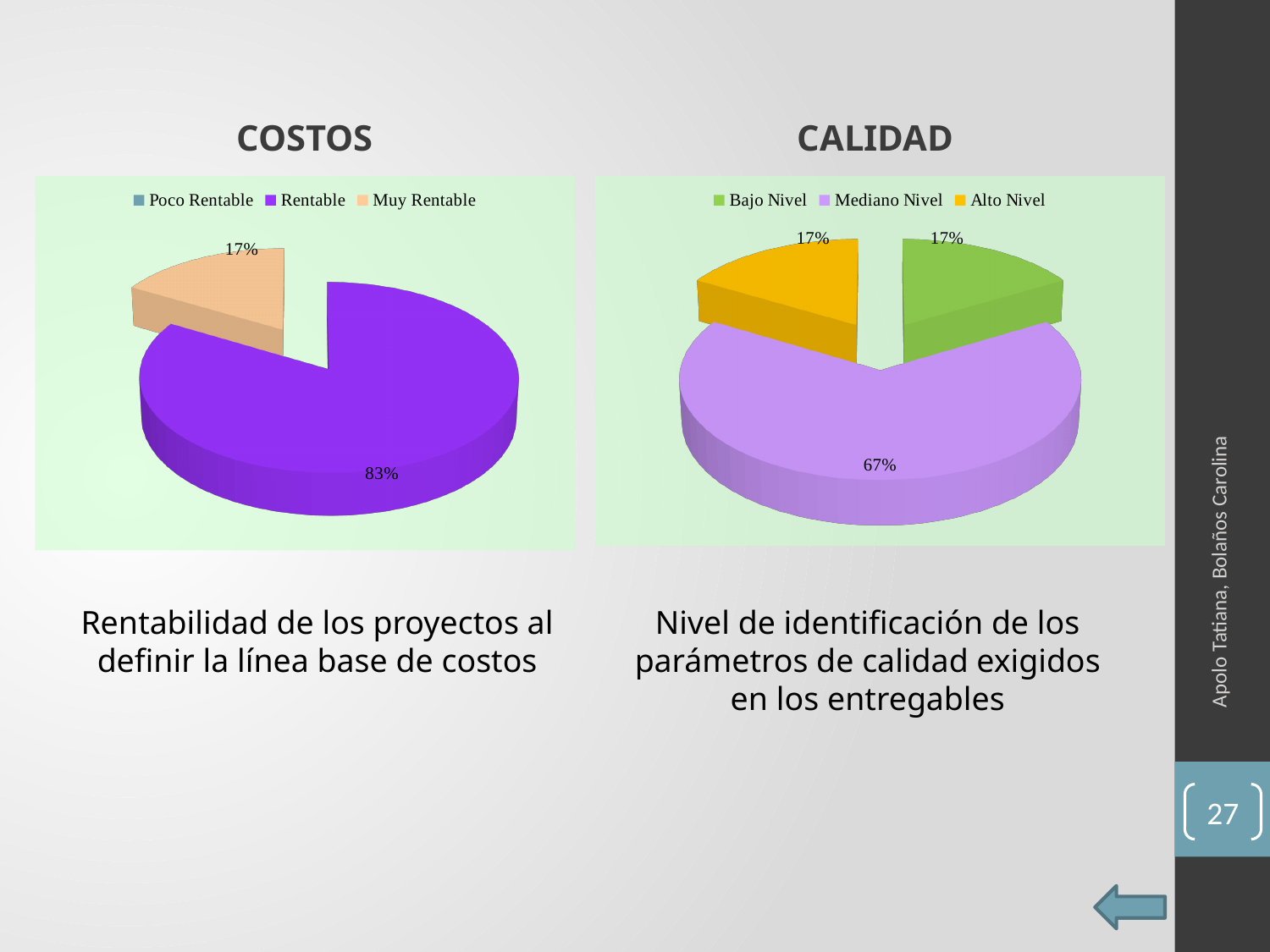
In the COSTOS chart, how many entries does the legend list? 3 In the CALIDAD chart, which category has the largest slice? Mediano Nivel In the COSTOS chart, which category has the largest slice? Rentable In the COSTOS chart, what share of the pie is labelled Muy Rentable? 17% In the CALIDAD chart, what is the difference between the Mediano Nivel and Alto Nivel shares? 50% In the CALIDAD chart, what colour is the Alto Nivel slice? Yellow What kind of chart is the COSTOS chart? Pie chart In the COSTOS chart, what share of the pie is labelled Rentable? 83% In the COSTOS chart, what is the difference between the Rentable and Muy Rentable shares? 66% In the CALIDAD chart, what share of the pie is labelled Bajo Nivel? 17% In the CALIDAD chart, how many entries does the legend list? 3